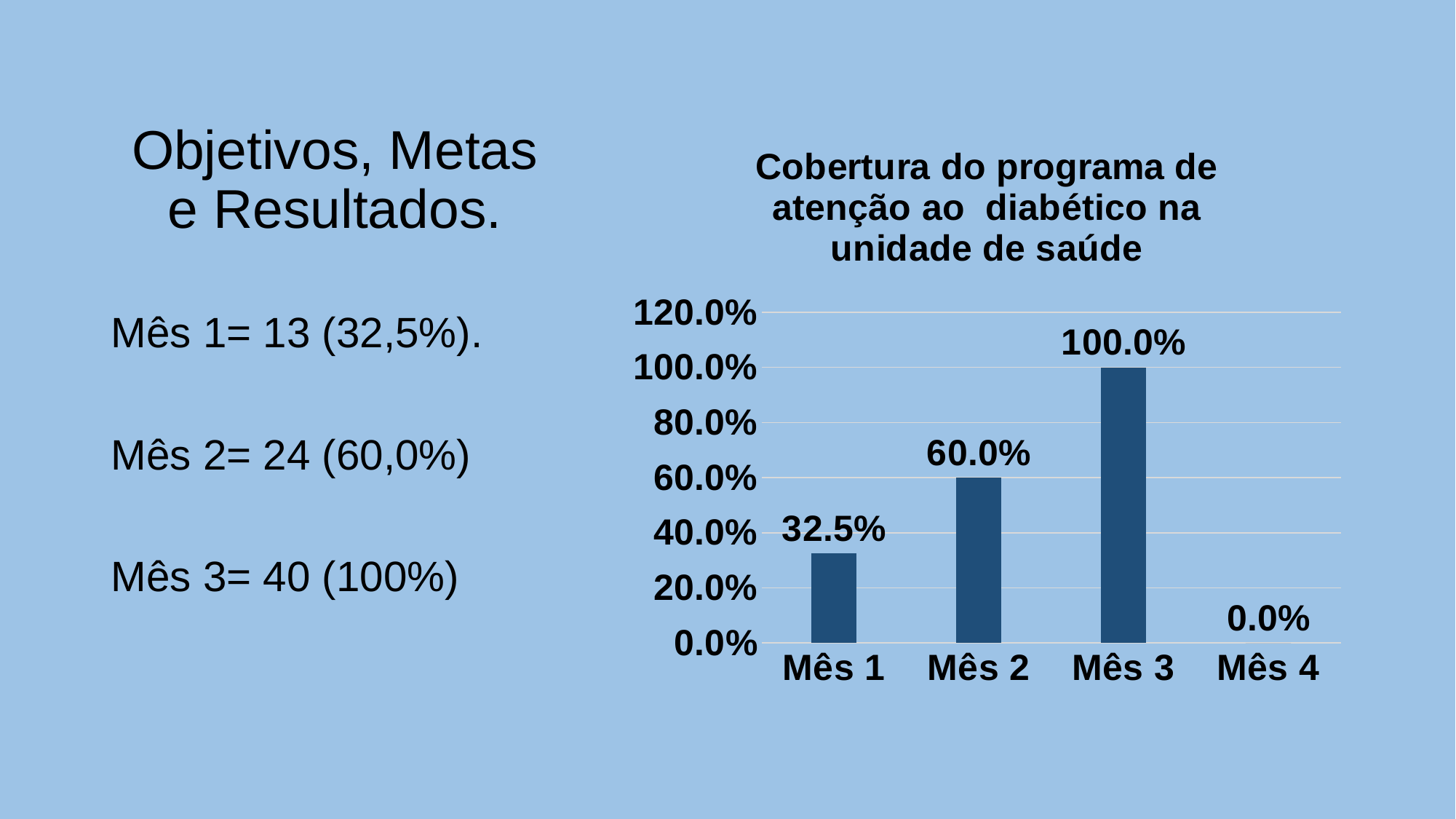
What is the value for Mês 3? 100.0% What is the value for Mês 4? 0.0% How many categories are shown on the x axis? 4 Do the values rise or fall from Mês 1 to Mês 3? Rise Which is larger, the value for Mês 1 or the value for Mês 2? Mês 2 What kind of chart is shown on the slide? Bar chart What is the difference between the values for Mês 3 and Mês 2? 40.0% Which category has the highest value? Mês 3 What is the value for Mês 2? 60.0% Which category has the lowest value? Mês 4 What is the value for Mês 1? 32.5% What is the title of the chart? Cobertura do programa de atenção ao diabético na unidade de saúde